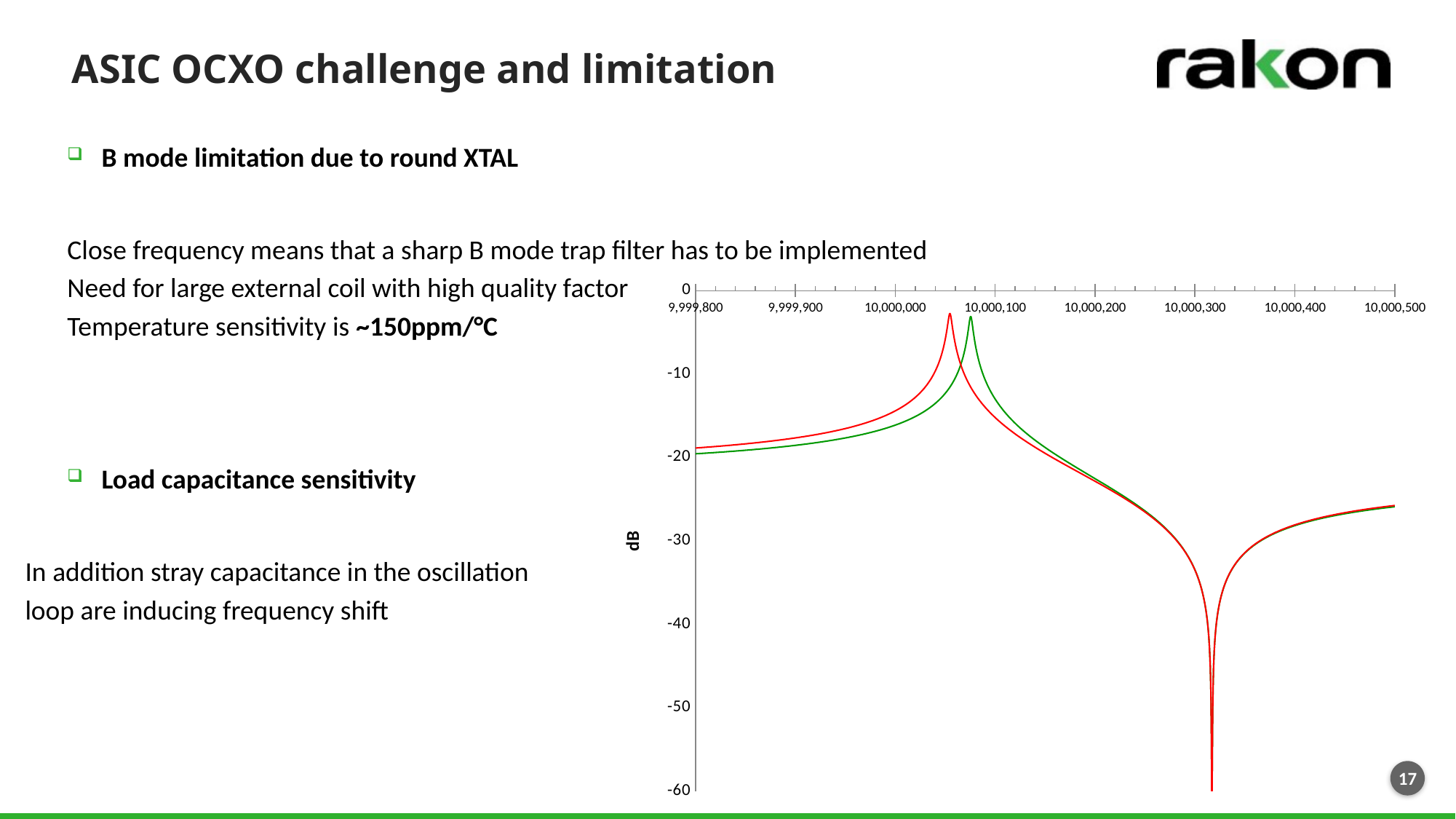
Between 10,000,100 and 10,000,300, do the values of the lines rise or fall? fall Is the value of the red line at 9,999,800 greater or less than -10? less Is the minimum value of the red line greater or less than -40? less Is the value of the green line at 10,000,500 greater or less than -30? greater At 9,999,800, which line has the higher value, the red line or the green line? red line Which line reaches its peak at a higher frequency, the red line or the green line? green line How many lines are plotted on the chart? 2 What kind of chart is shown on the slide? line chart What is the lowest value shown on the vertical axis of the chart? -60 Between 10,000,300 and 10,000,500, do the values of the lines rise or fall? rise What is the label on the vertical axis of the chart? dB